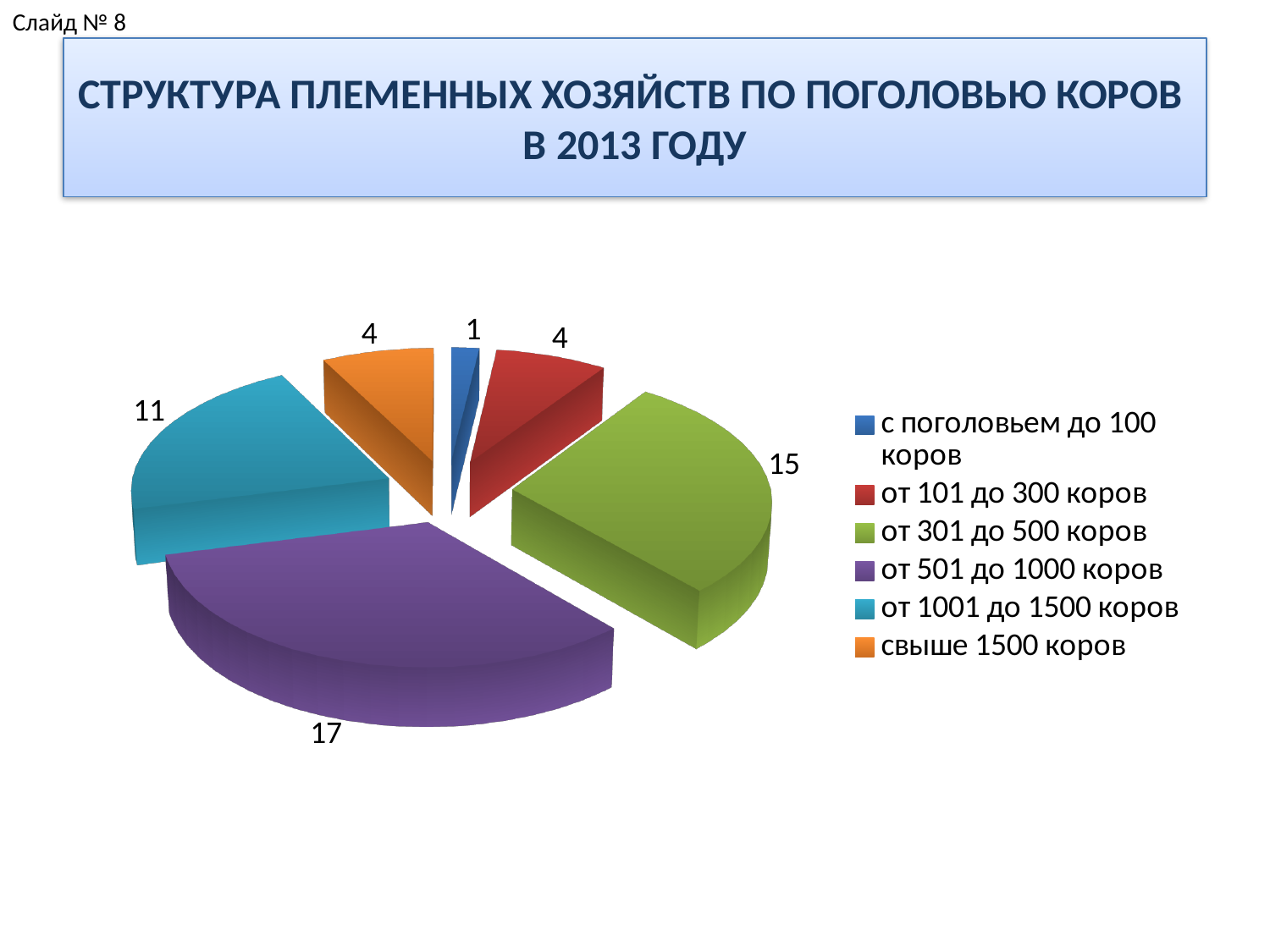
What value is shown for the slice "от 301 до 500 коров"? 15 Which is larger: the value for "от 1001 до 1500 коров" or the value for "свыше 1500 коров"? от 1001 до 1500 коров What is the total of all the values shown on the pie chart? 52 What value is shown for the slice "от 1001 до 1500 коров"? 11 What value is shown for the slice "с поголовьем до 100 коров"? 1 What colour is the slice for "от 301 до 500 коров"? green What value is shown for the slice "от 501 до 1000 коров"? 17 Which category has the smallest slice of the pie? с поголовьем до 100 коров Which category has the largest slice of the pie? от 501 до 1000 коров What is the difference between the values for "от 501 до 1000 коров" and "от 301 до 500 коров"? 2 How many slices does the pie chart have? 6 What type of chart is shown on the slide? pie chart